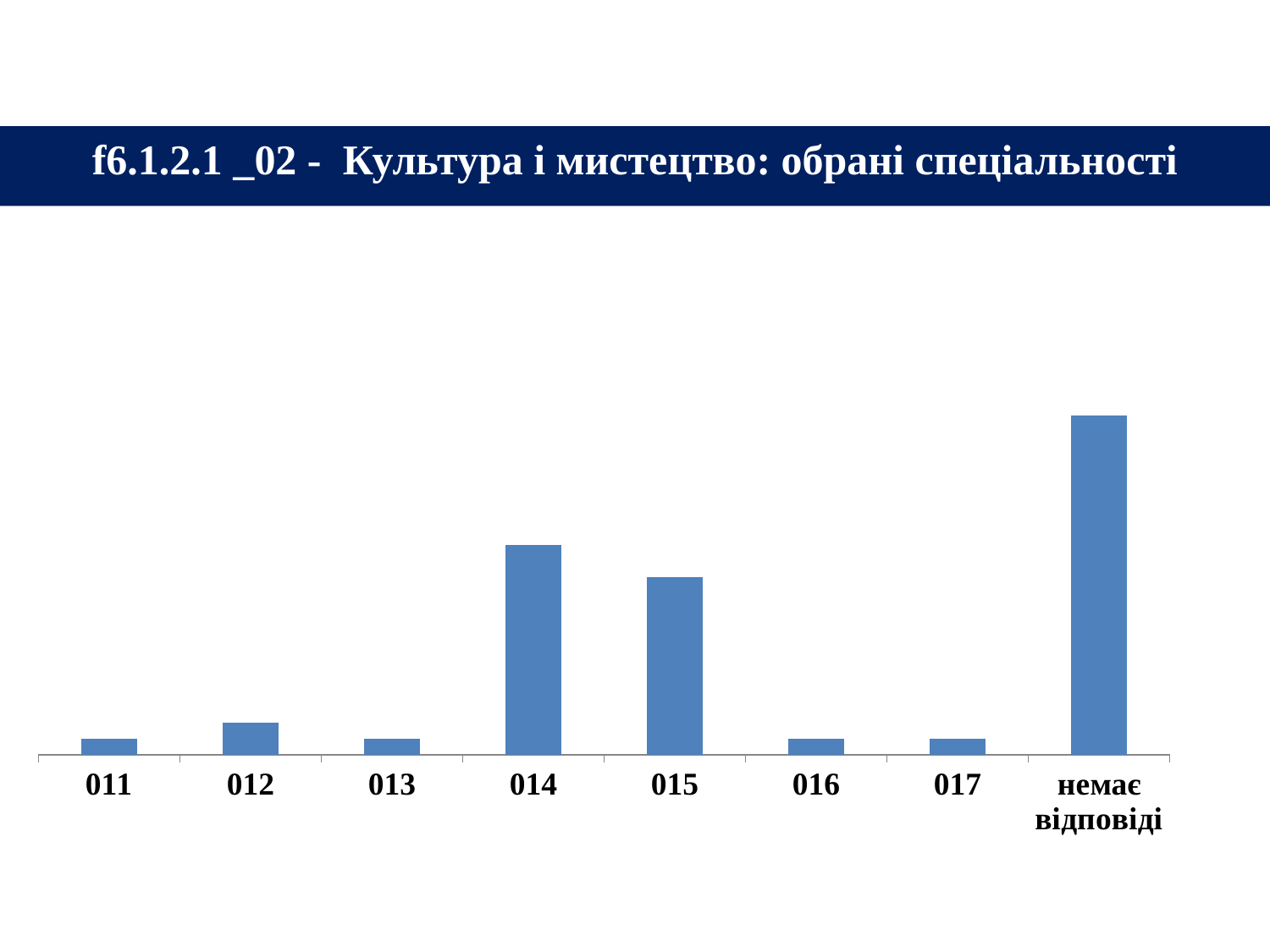
Which bar is taller, 014 or 015? 014 What colour are the bars in the chart? Blue Which bar is taller, 015 or 016? 015 Which bar is taller, 'немає відповіді' or 014? немає відповіді What kind of chart is shown on the slide? Bar chart Which category has the highest bar in the chart? немає відповіді How many categories are shown on the x axis of the chart? 8 Which of the numbered specialities (011–017) has the tallest bar? 014 What is the title of the slide containing the chart? f6.1.2.1 _02 - Культура і мистецтво: обрані спеціальності